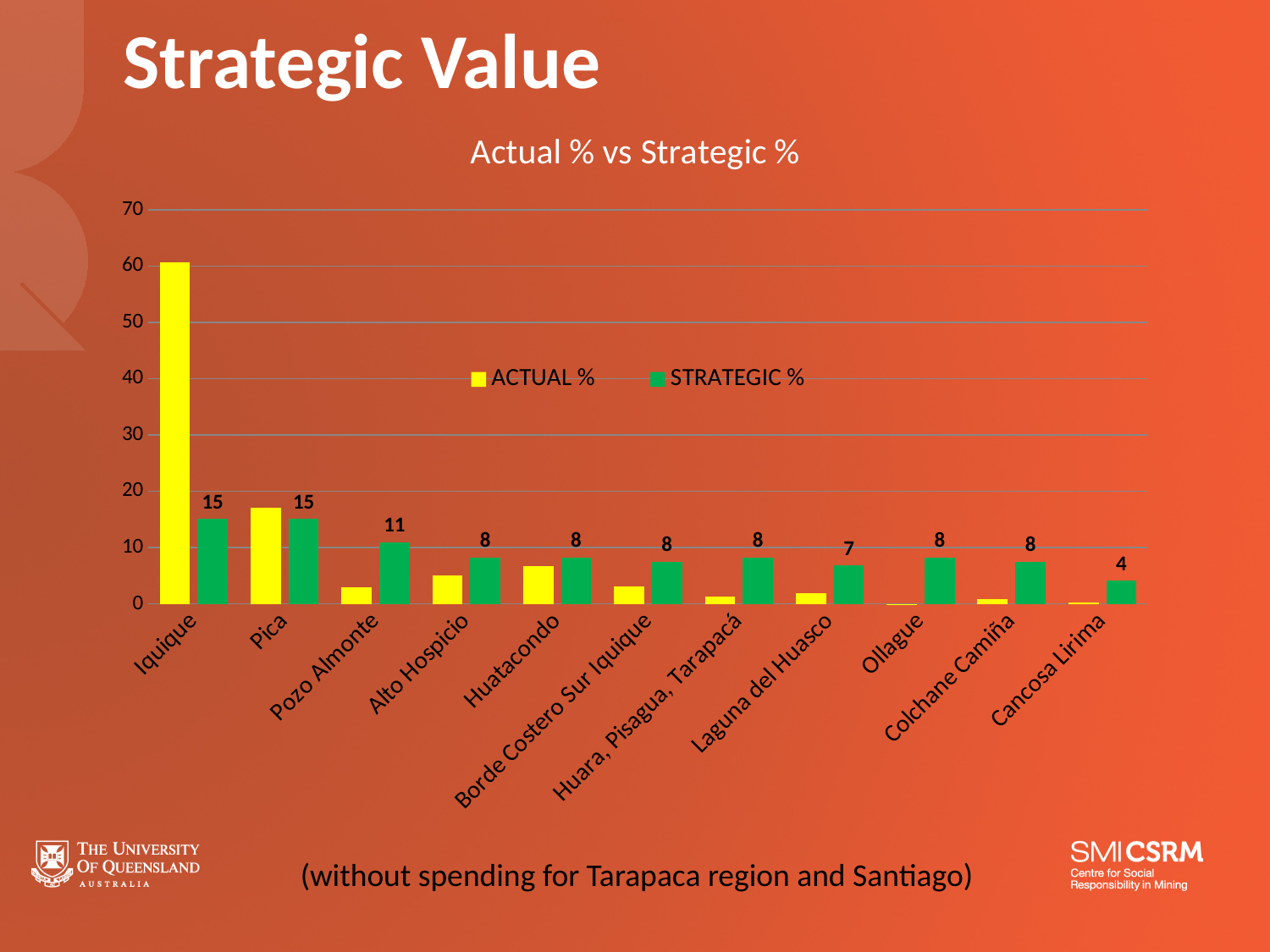
What is the STRATEGIC % value for Pozo Almonte? 11 What is the STRATEGIC % value for Iquique? 15 Is the ACTUAL % value for Pozo Almonte greater or less than 10? less Which category has the highest ACTUAL % value? Iquique Is the ACTUAL % value for Iquique greater or less than 50? greater How many categories are shown on the x axis of the chart? 11 How many series does the chart's legend list? 2 Which has a larger STRATEGIC % value, Pozo Almonte or Laguna del Huasco? Pozo Almonte What is the difference between the STRATEGIC % values for Pica and Cancosa Lirima? 11 Which category has the lowest STRATEGIC % value? Cancosa Lirima What is the STRATEGIC % value for Cancosa Lirima? 4 What is the STRATEGIC % value for Laguna del Huasco? 7